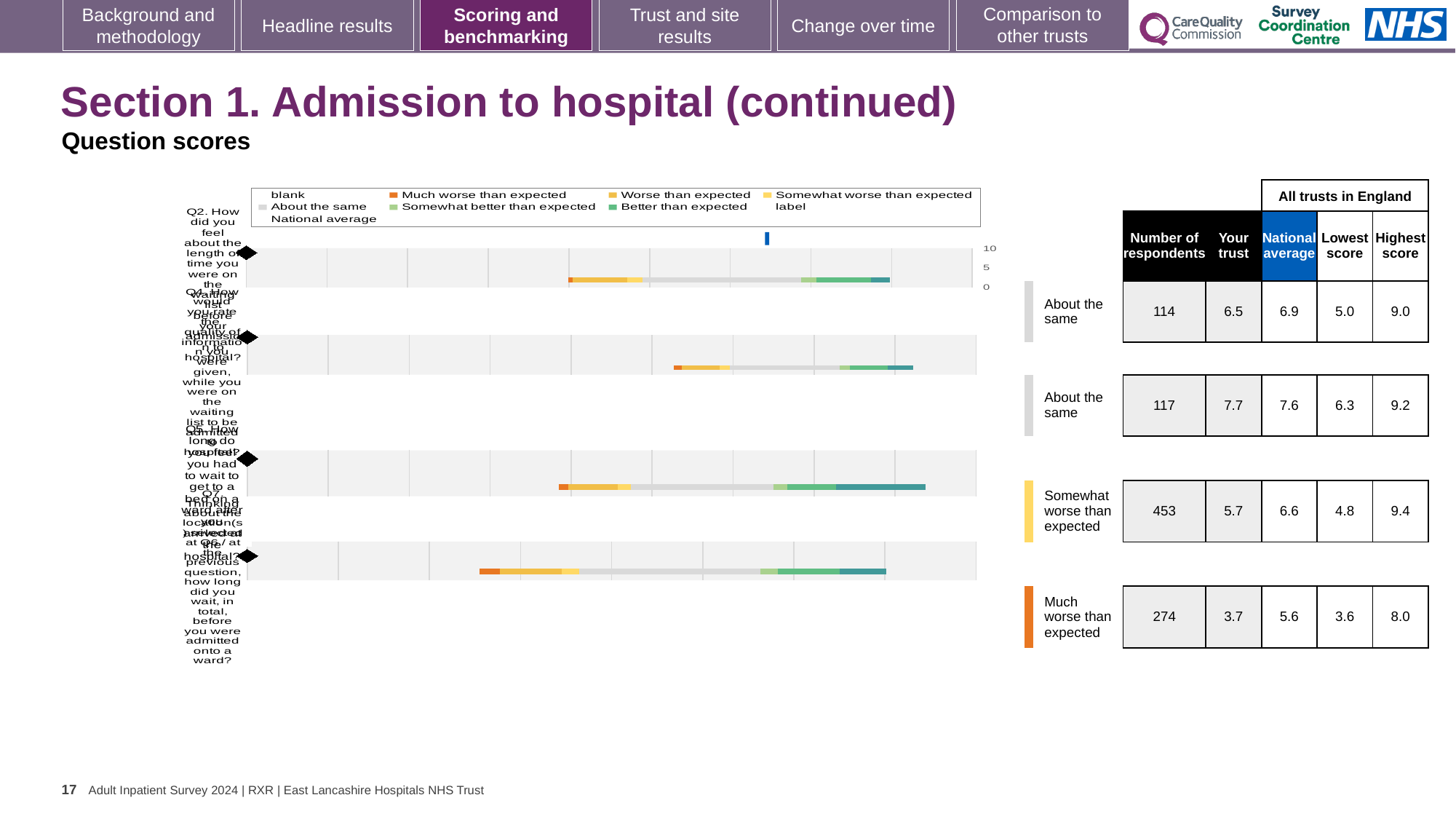
How many question bars are plotted in the chart? 4 In the table beside the chart, what is the national average for the row rated 'Much worse than expected'? 5.6 In the table beside the chart, which row has the lowest number of respondents? the first 'About the same' row (114) In the table beside the chart, what is the highest score for the row rated 'Somewhat worse than expected'? 9.4 In the table beside the chart, which row has the highest number of respondents? Somewhat worse than expected (453) Which colour in the chart legend represents 'Much worse than expected'? orange In the table beside the chart, what is the difference between the national average and the 'Your trust' score for the row rated 'Much worse than expected'? 1.9 In the table beside the chart, what is the 'Your trust' score for the row rated 'Somewhat worse than expected'? 5.7 In the table beside the chart, for the row rated 'Somewhat worse than expected', which is larger: the 'Your trust' score or the national average? national average What is the maximum value shown on the chart's score axis? 10 In the table beside the chart, what is the number of respondents for the row rated 'Much worse than expected'? 274 What kind of chart is shown on the slide? bar chart